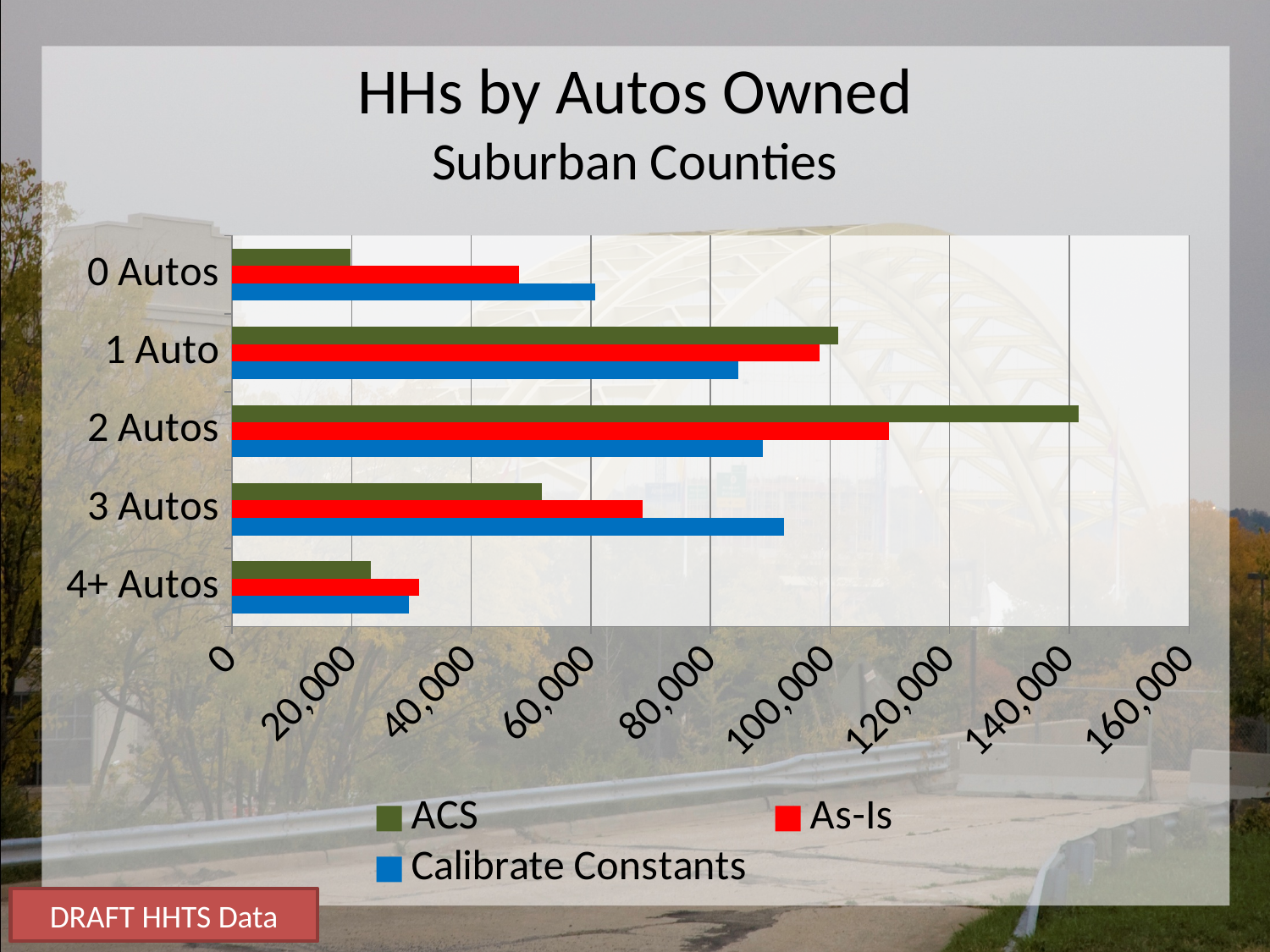
Which category has the highest Calibrate Constants value? 3 Autos Is the ACS value for 4+ Autos greater or less than 40,000? less For 3 Autos, which is larger: the ACS value or the Calibrate Constants value? Calibrate Constants Which category has the highest ACS value? 2 Autos How many auto-ownership categories are shown on the chart? 5 Which series is shown in red in the legend? As-Is How many series does the legend list? 3 Is the ACS value for 2 Autos greater or less than 120,000? greater For 0 Autos, which is larger: the ACS value or the As-Is value? As-Is What kind of chart is shown on the slide? bar chart Is the Calibrate Constants value for 0 Autos greater or less than 40,000? greater Which category has the lowest ACS value? 0 Autos